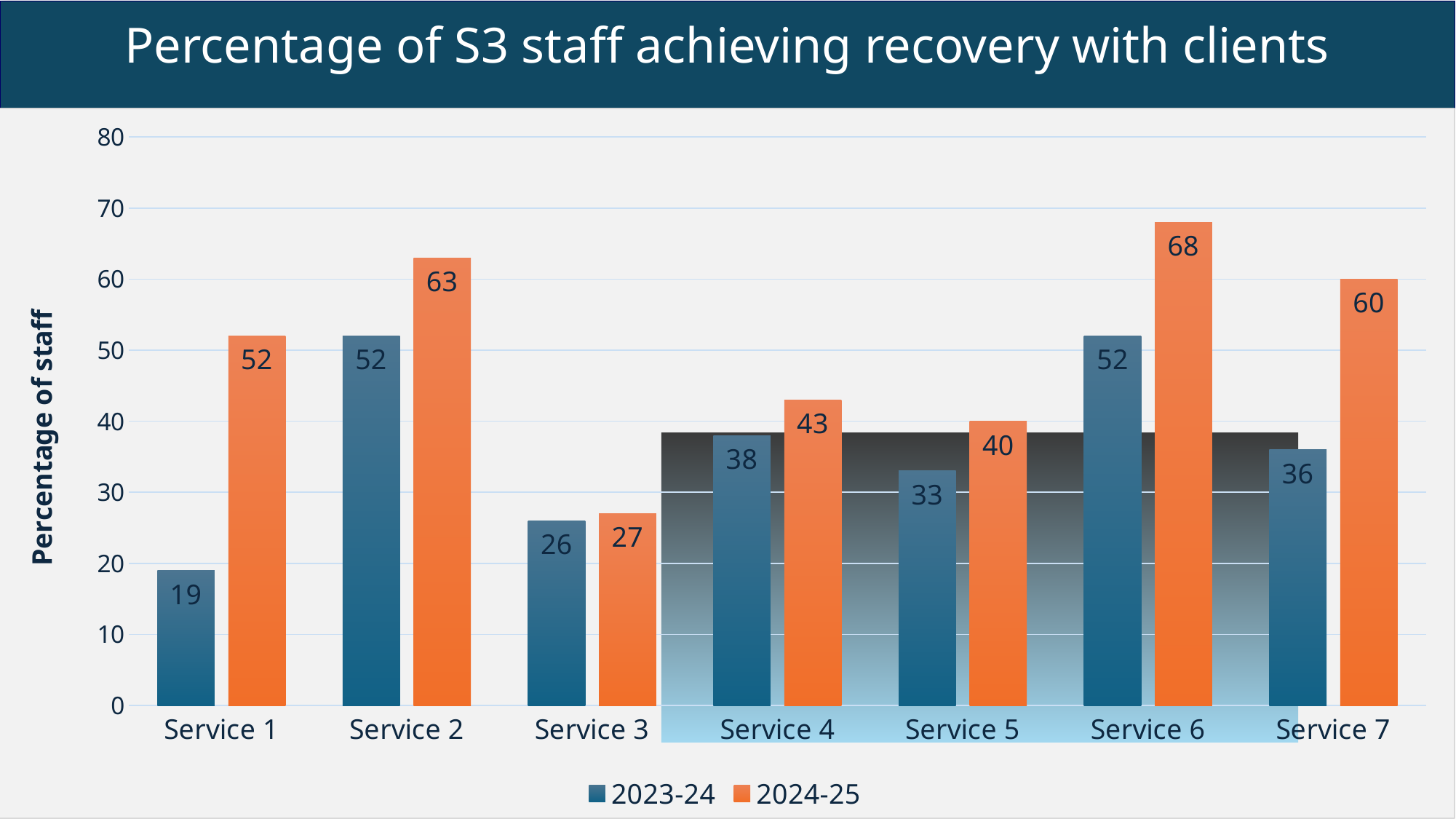
What is the title of the chart? Percentage of S3 staff achieving recovery with clients What is the value for Service 4 in the 2023-24 series? 38 What is the difference between the 2024-25 and 2023-24 values for Service 1? 33 What kind of chart is shown on the slide? Bar chart What is the value for Service 6 in the 2024-25 series? 68 How many services are shown on the x axis? 7 Which service has the highest value in the 2024-25 series? Service 6 Which service has the lowest value in the 2023-24 series? Service 1 Which is larger for Service 7: the 2023-24 value or the 2024-25 value? 2024-25 What is the value for Service 1 in the 2023-24 series? 19 Is the 2024-25 value for Service 2 greater or less than 60? greater How many series does the legend list? 2